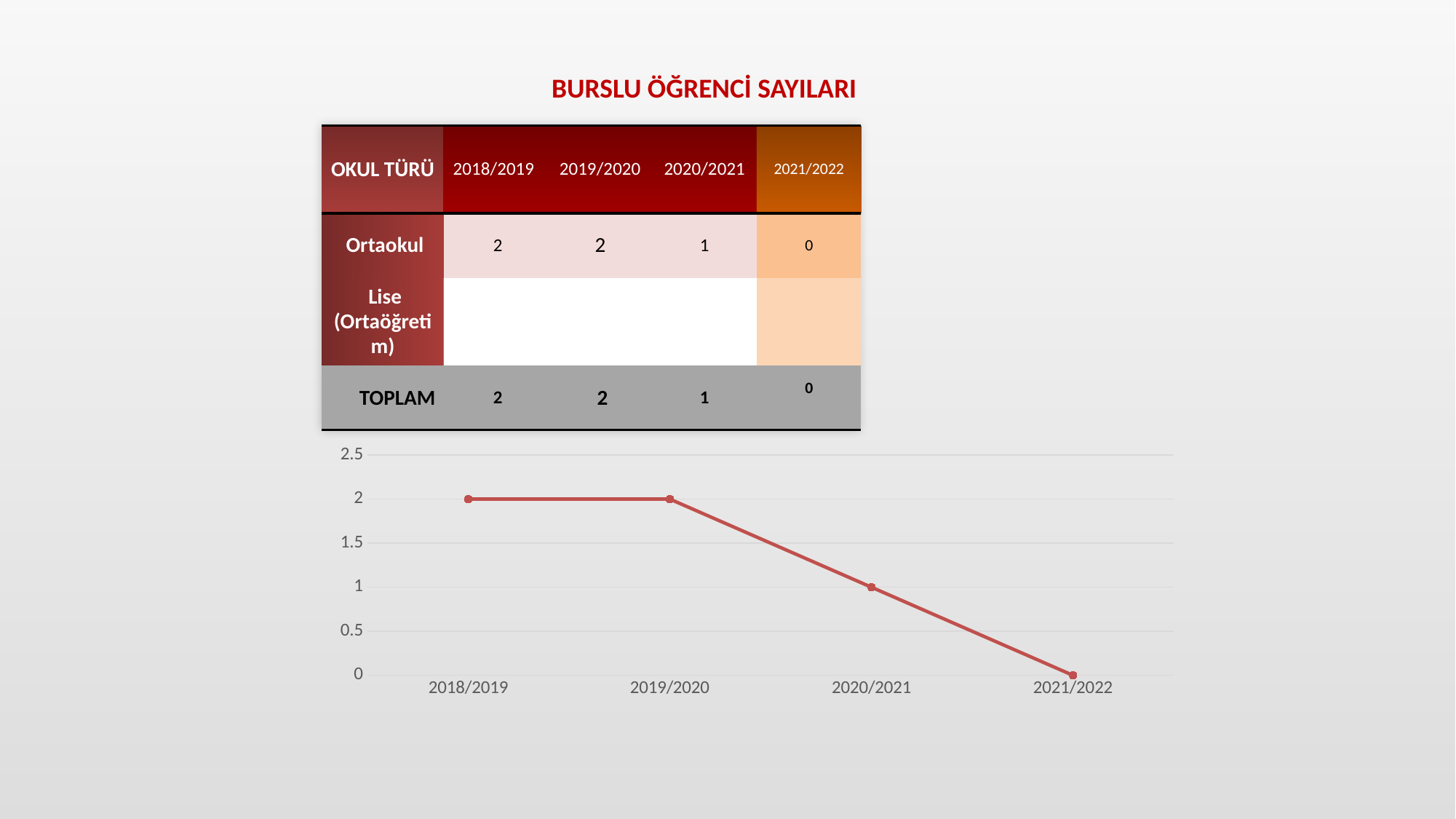
What is the value plotted for 2018/2019 on the line chart? 2 What is the title shown above the table on the slide? BURSLU ÖĞRENCİ SAYILARI Which is larger on the line chart, the value for 2019/2020 or the value for 2021/2022? 2019/2020 Is the value for 2020/2021 on the line chart greater or less than 1.5? less What kind of chart is shown on the slide? line chart What is the difference between the values for 2019/2020 and 2020/2021 on the line chart? 1 Which year has the lowest value on the line chart? 2021/2022 What is the highest value shown on the vertical axis of the line chart? 2.5 What is the value plotted for 2020/2021 on the line chart? 1 How many points are plotted on the line chart? 4 Do the values on the line chart rise or fall from 2019/2020 to 2021/2022? fall What is the value plotted for 2021/2022 on the line chart? 0